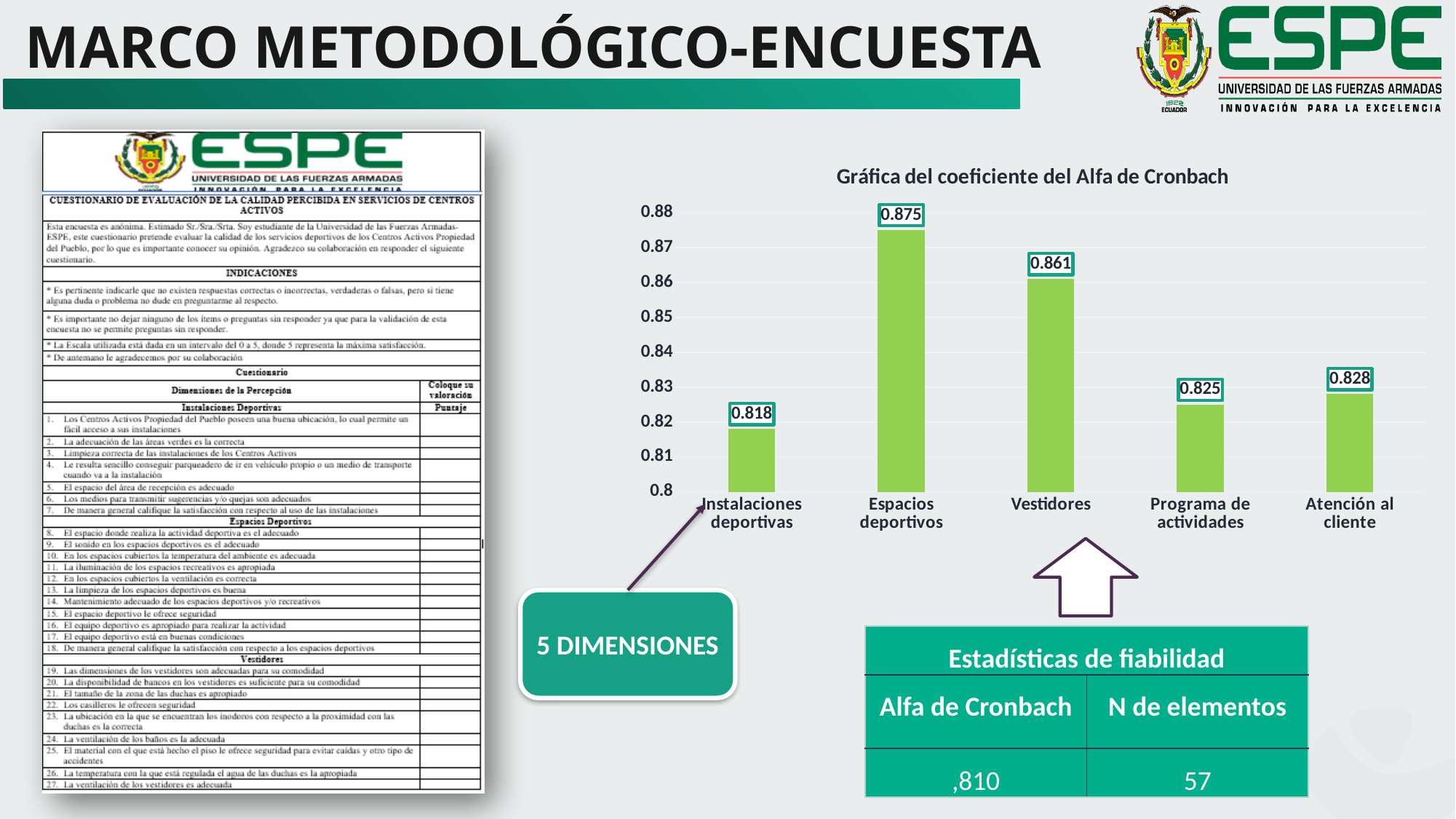
Which is larger in the Alfa de Cronbach chart, Programa de actividades or Atención al cliente? Atención al cliente Which category has the lowest value in the Alfa de Cronbach chart? Instalaciones deportivas What is the value for Instalaciones deportivas in the Alfa de Cronbach chart? 0.818 What is the difference between the values for Espacios deportivos and Vestidores in the Alfa de Cronbach chart? 0.014 How many categories are shown in the Alfa de Cronbach chart? 5 What is the value for Vestidores in the Alfa de Cronbach chart? 0.861 What kind of chart is the Gráfica del coeficiente del Alfa de Cronbach? bar chart What is the title of the chart on the slide? Gráfica del coeficiente del Alfa de Cronbach Which category has the highest value in the Alfa de Cronbach chart? Espacios deportivos Is the value for Vestidores in the Alfa de Cronbach chart greater or less than 0.85? greater What is the value for Espacios deportivos in the Alfa de Cronbach chart? 0.875 What is the value for Atención al cliente in the Alfa de Cronbach chart? 0.828